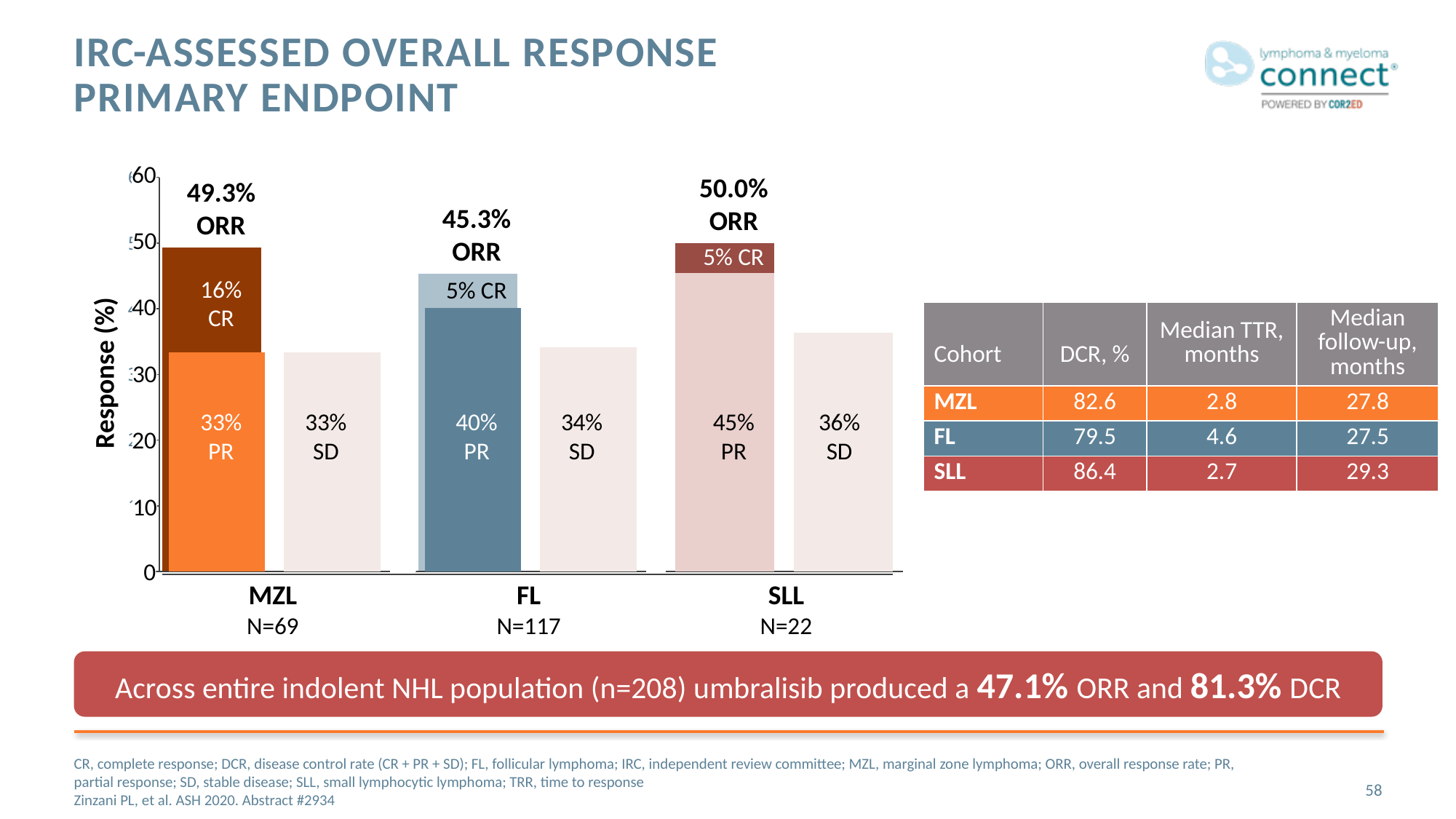
What is the SD value for the SLL cohort? 36% Which cohort has the lowest ORR? FL What is the difference between the CR value for MZL and the CR value for FL? 11% How many cohorts are shown on the x axis of the chart? 3 What is the ORR for the SLL cohort? 50.0% What is the CR value for the FL cohort? 5% What kind of chart is shown on the slide? bar chart Is the ORR bar for MZL greater or less than 40 on the Response (%) axis? greater What is the PR value for the MZL cohort? 33% Which cohort has the larger PR value, SLL or FL? SLL What is the difference between the ORR for SLL and the ORR for FL? 4.7% Which cohort has the highest ORR? SLL